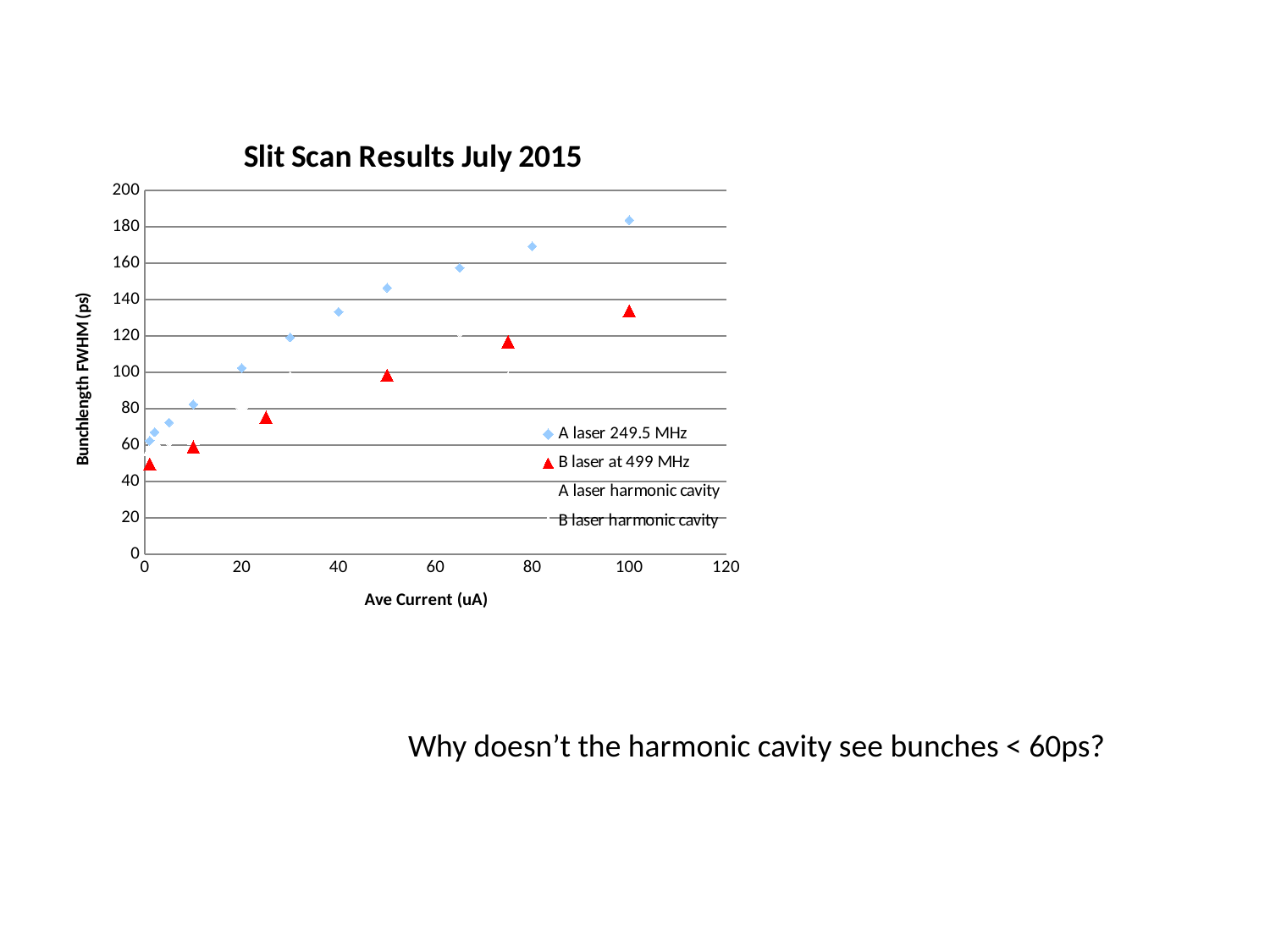
Do the bunchlength values for the A laser 249.5 MHz series rise or fall as average current increases? rise Is the bunchlength for the B laser at 499 MHz series at 25 uA greater or less than 80? less How many series does the legend list? 4 What kind of chart is shown on the slide? scatter chart What is the label of the y axis? Bunchlength FWHM (ps) Is the bunchlength for the B laser at 499 MHz series at 75 uA greater or less than 100? greater Is the bunchlength for the A laser 249.5 MHz series at 80 uA greater or less than 180? less How many data points are plotted for the B laser at 499 MHz series? 6 What is the title of the chart? Slit Scan Results July 2015 At 100 uA, which series has the larger bunchlength: A laser 249.5 MHz or B laser at 499 MHz? A laser 249.5 MHz